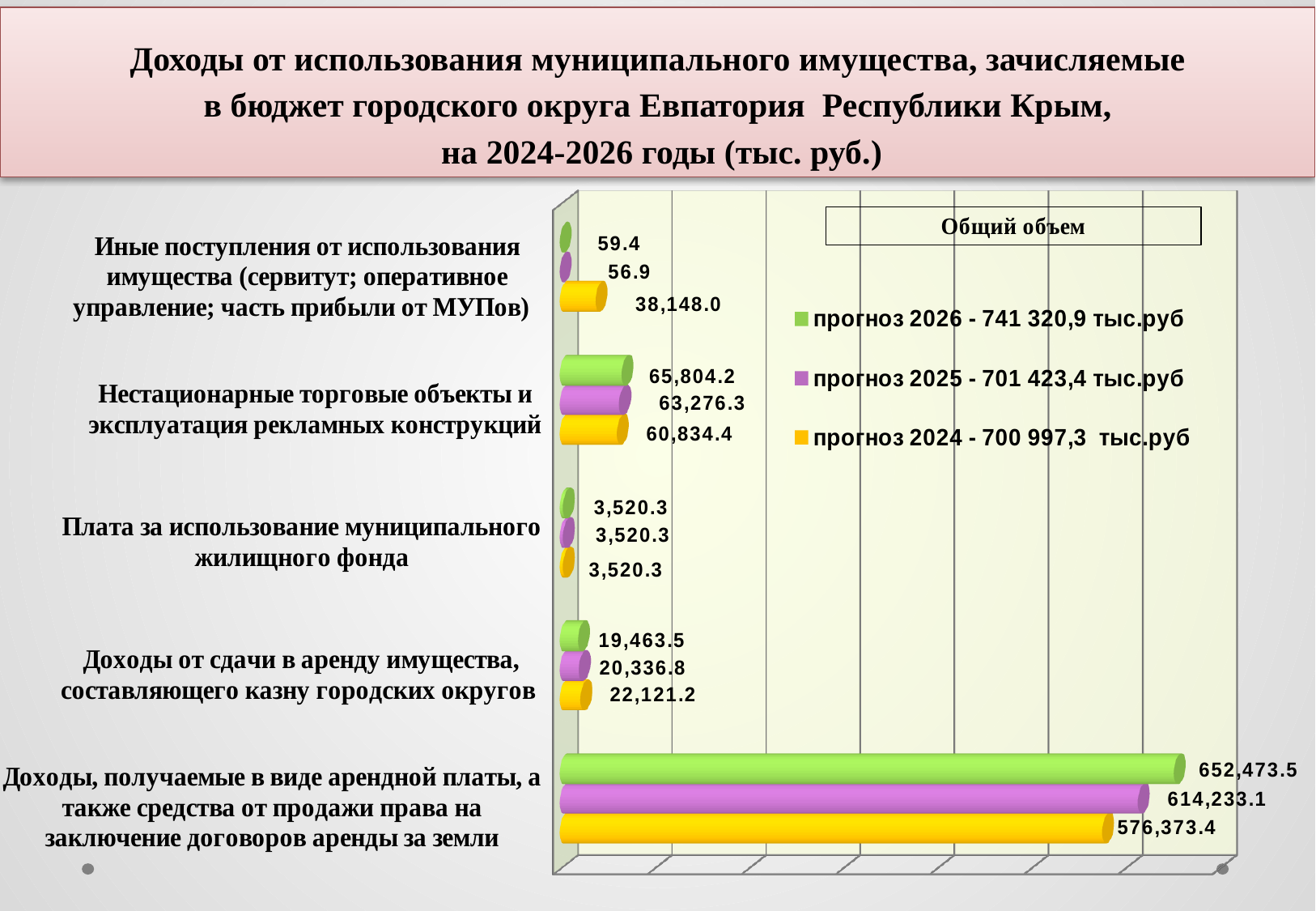
What is the difference between the прогноз 2026 and прогноз 2024 values for 'Нестационарные торговые объекты и эксплуатация рекламных конструкций'? 4,969.8 Which category has the lowest прогноз 2025 value? Иные поступления от использования имущества (сервитут; оперативное управление; часть прибыли от МУПов) What is the прогноз 2024 value for 'Доходы от сдачи в аренду имущества, составляющего казну городских округов'? 22,121.2 How many categories are shown on the chart? 5 How many series does the legend list? 3 What is the прогноз 2026 value for 'Доходы, получаемые в виде арендной платы, а также средства от продажи права на заключение договоров аренды за земли'? 652,473.5 For 'Доходы от сдачи в аренду имущества, составляющего казну городских округов', which is larger: the прогноз 2024 value or the прогноз 2026 value? прогноз 2024 Which category has the highest прогноз 2026 value? Доходы, получаемые в виде арендной платы, а также средства от продажи права на заключение договоров аренды за земли What is the прогноз 2025 value for 'Нестационарные торговые объекты и эксплуатация рекламных конструкций'? 63,276.3 What is the прогноз 2024 value for 'Иные поступления от использования имущества (сервитут; оперативное управление; часть прибыли от МУПов)'? 38,148.0 What kind of chart is shown on the slide? Bar chart What is the difference between the прогноз 2026 and прогноз 2024 values for 'Доходы, получаемые в виде арендной платы, а также средства от продажи права на заключение договоров аренды за земли'? 76,100.1